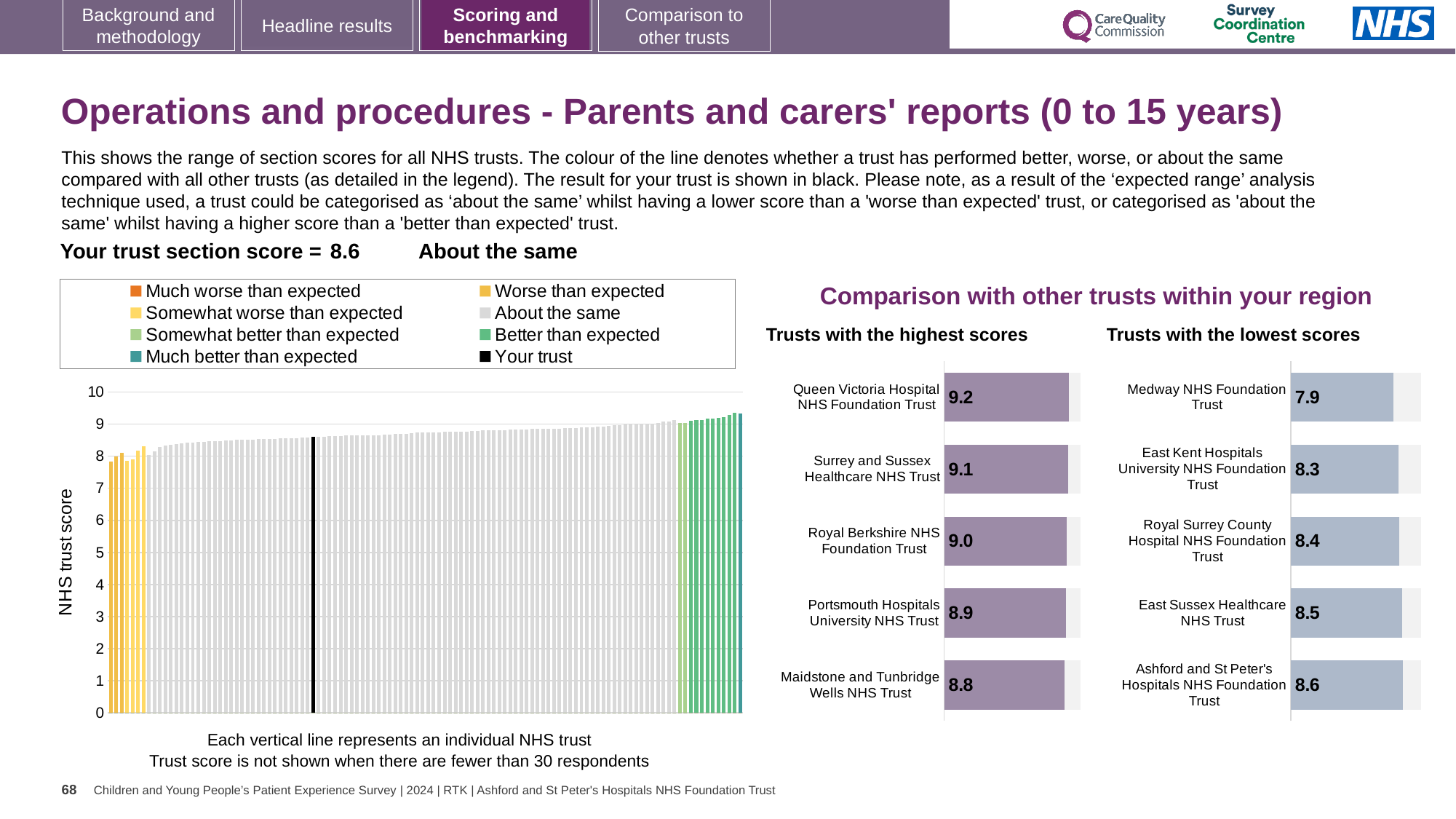
In the 'Trusts with the lowest scores' chart, what is the score for Royal Surrey County Hospital NHS Foundation Trust? 8.4 In the 'Trusts with the highest scores' chart, which trust has the highest score? Queen Victoria Hospital NHS Foundation Trust In the 'Trusts with the highest scores' chart, what is the score for Maidstone and Tunbridge Wells NHS Trust? 8.8 In the 'Trusts with the lowest scores' chart, what is the score for Medway NHS Foundation Trust? 7.9 In the 'Trusts with the lowest scores' chart, what is the difference between the scores of Ashford and St Peter's Hospitals NHS Foundation Trust and Medway NHS Foundation Trust? 0.7 In the 'Trusts with the lowest scores' chart, which has the larger score: East Kent Hospitals University NHS Foundation Trust or East Sussex Healthcare NHS Trust? East Sussex Healthcare NHS Trust In the 'Trusts with the highest scores' chart, what is the score for Queen Victoria Hospital NHS Foundation Trust? 9.2 How many trusts are shown in the 'Trusts with the highest scores' chart? 5 How many entries does the legend of the large 'NHS trust score' chart on the left list? 8 In the 'Trusts with the highest scores' chart, what is the difference between the scores of Queen Victoria Hospital NHS Foundation Trust and Maidstone and Tunbridge Wells NHS Trust? 0.4 In the large 'NHS trust score' chart on the left, is the value for the black 'Your trust' bar greater or less than 8? greater In the 'Trusts with the lowest scores' chart, which trust has the lowest score? Medway NHS Foundation Trust